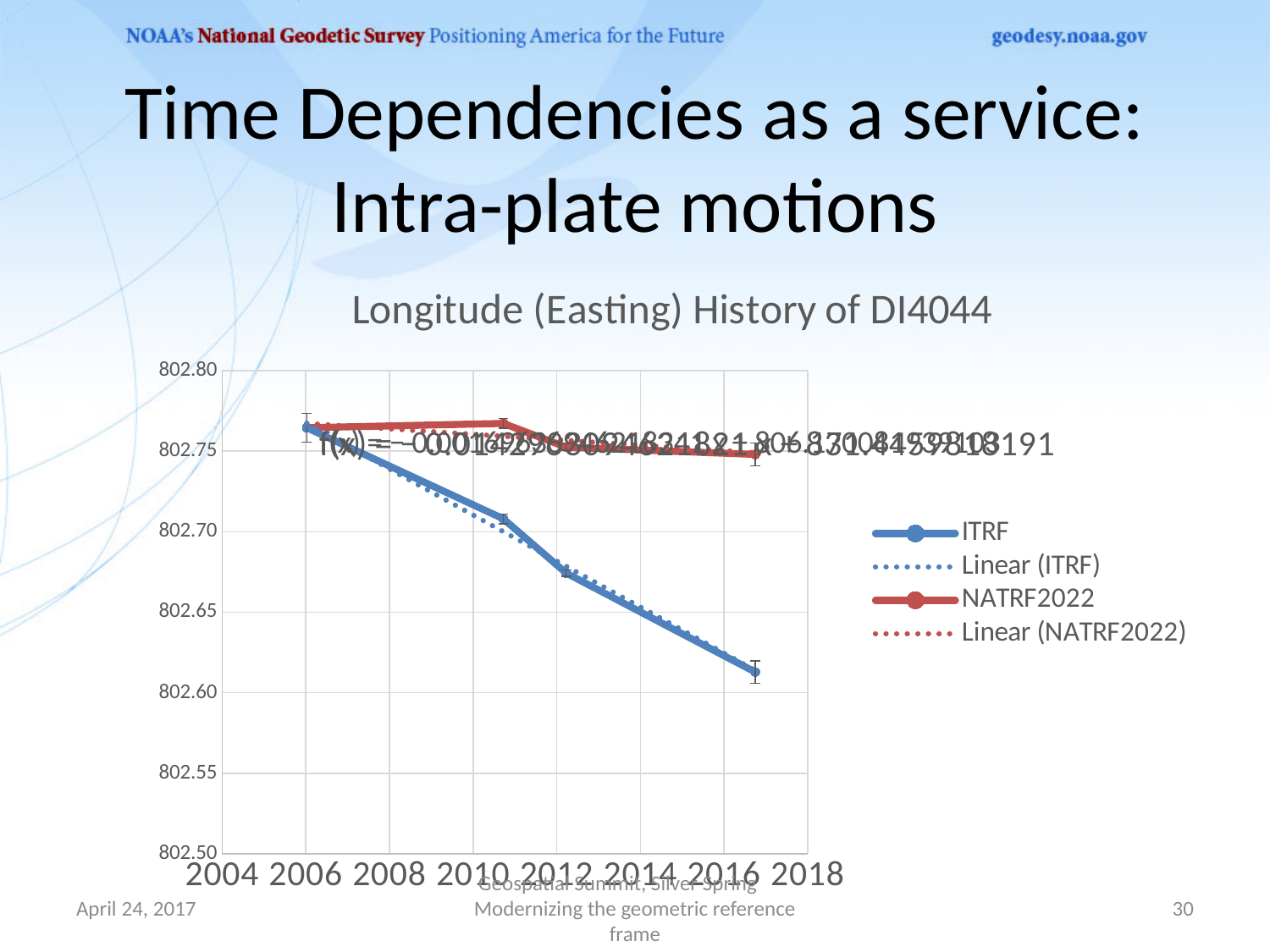
How many data points are plotted for the ITRF series? 4 In which year does the ITRF series reach its lowest value? 2016 Does the ITRF series rise or fall as the years increase along the x axis? fall What type of chart is shown on the slide? line chart What is the title of the chart? Longitude (Easting) History of DI4044 Is the NATRF2022 value at 2006 greater or less than 802.75? greater In which year does the ITRF series reach its highest value? 2006 At 2016, which series has the larger value, ITRF or NATRF2022? NATRF2022 How many entries does the chart legend list? 4 Which colour is used for the NATRF2022 series in the chart? red Is the ITRF value at 2016 greater or less than 802.65? less Is the ITRF value at 2012 greater or less than 802.70? less